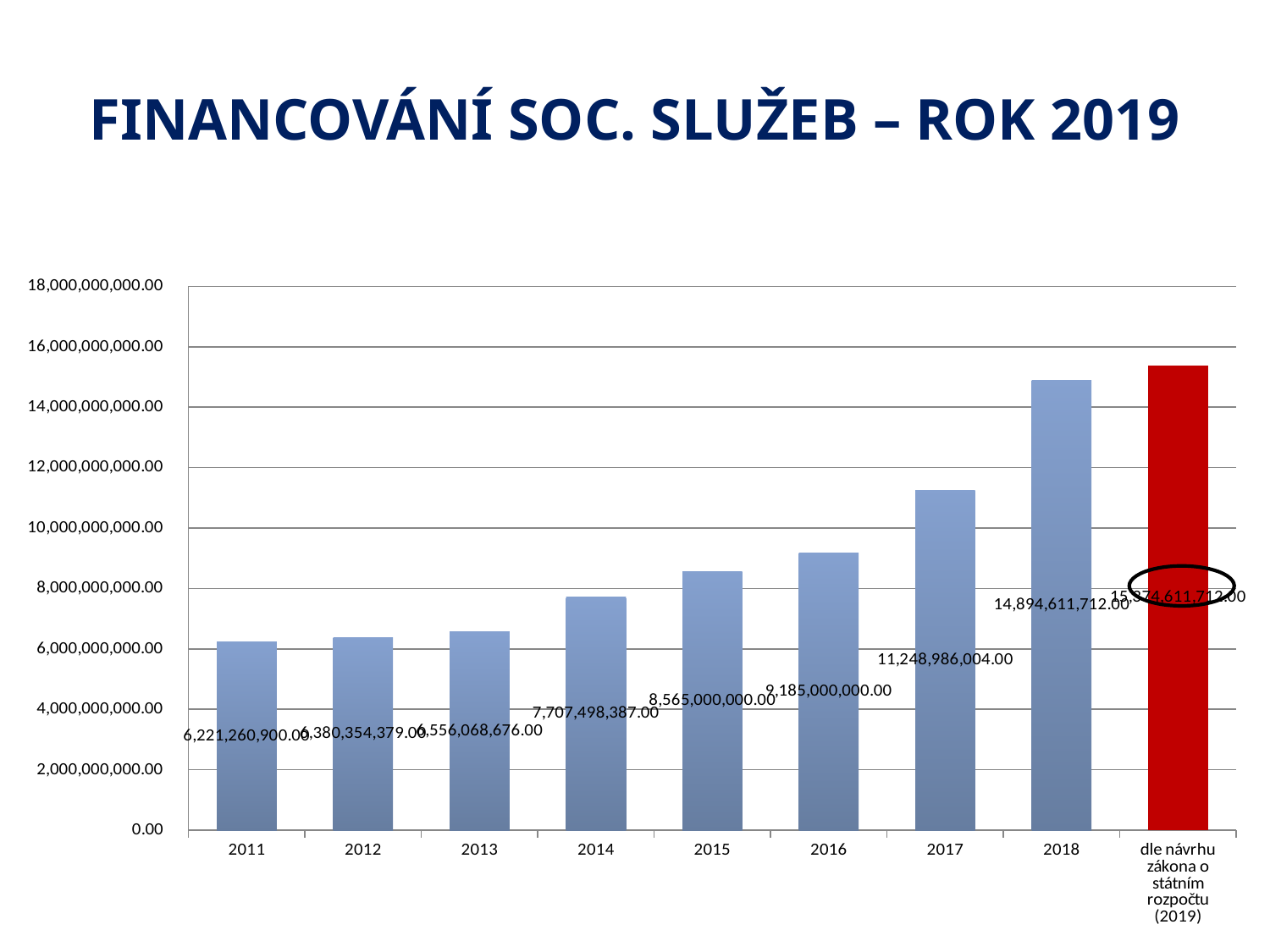
Is the value for 'dle návrhu zákona o státním rozpočtu (2019)' greater or less than 14,000,000,000.00? greater Which category has the lowest value? 2011 What is the difference between the values for 2018 and 2017? 3,645,625,708.00 What is the value for 2018? 14,894,611,712.00 What type of chart is shown on the slide? bar chart What is the value for 2011? 6,221,260,900.00 What is the value for 2014? 7,707,498,387.00 How many bars are plotted in the chart? 9 Which category has the highest value? dle návrhu zákona o státním rozpočtu (2019) Do the values rise or fall from 2011 to 2018? rise What is the difference between the values for 2016 and 2015? 620,000,000.00 What is the value for 2017? 11,248,986,004.00